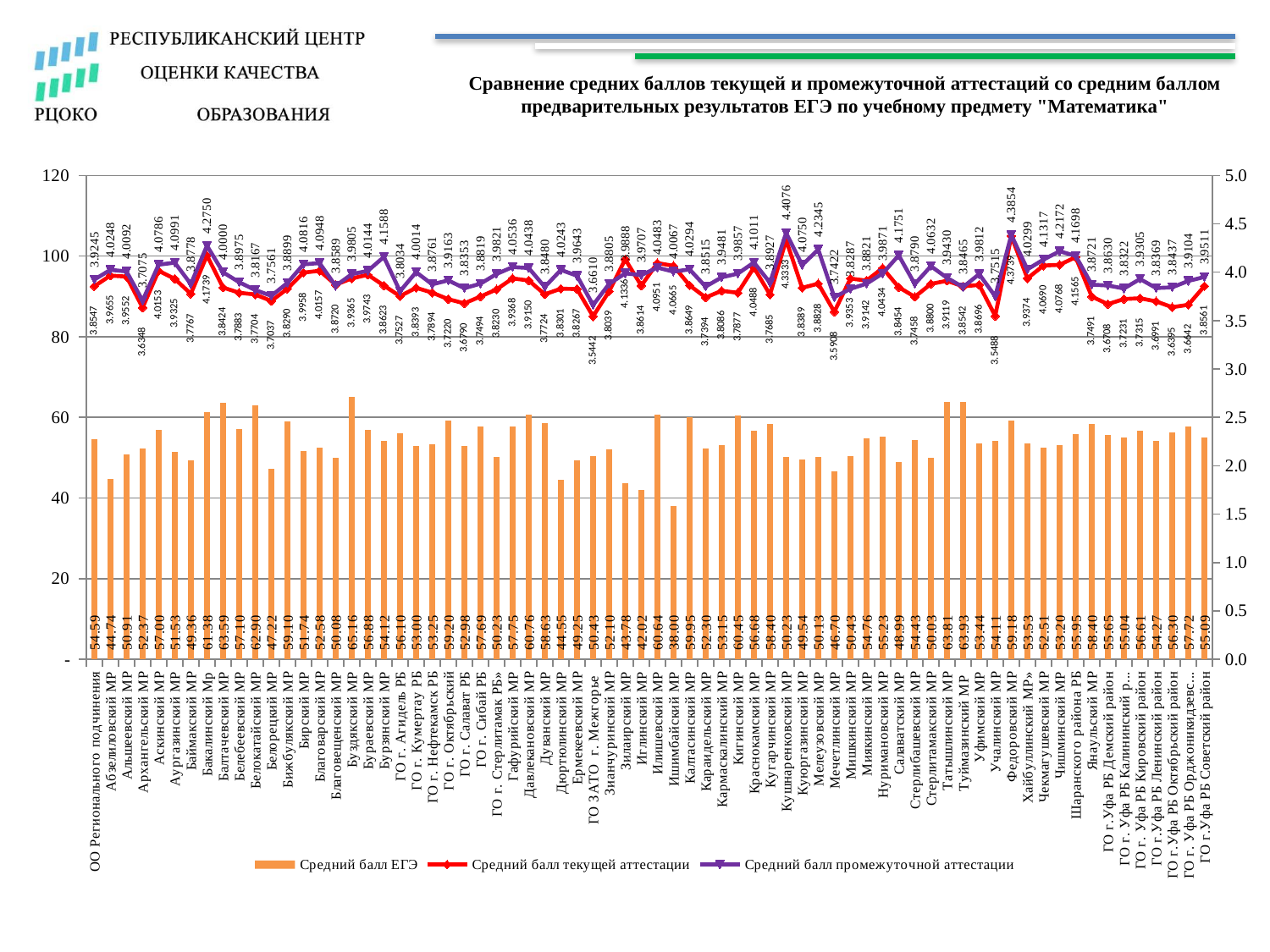
What is the difference between the Средний балл ЕГЭ for Буздякский МР and Ишимбайский МР? 27.16 What kind of chart is shown on the slide? A combined bar and line chart What is the Средний балл ЕГЭ for Бакалинский МР? 61.38 Which category has the highest Средний балл ЕГЭ? Буздякский МР What is the Средний балл текущей аттестации for ОО Регионального подчинения? 3.8547 Which category has the lowest Средний балл ЕГЭ? Ишимбайский МР How many series does the legend list? 3 What is the Средний балл промежуточной аттестации for Кушнаренковский МР? 4.4076 What is the Средний балл ЕГЭ for Зилаирский МР? 43.78 Which has a higher Средний балл ЕГЭ, Татышлинский МР or Туймазинский МР? Туймазинский МР Is the Средний балл ЕГЭ for Иглинский МР greater or less than 60? less Which category has the highest Средний балл промежуточной аттестации? Кушнаренковский МР